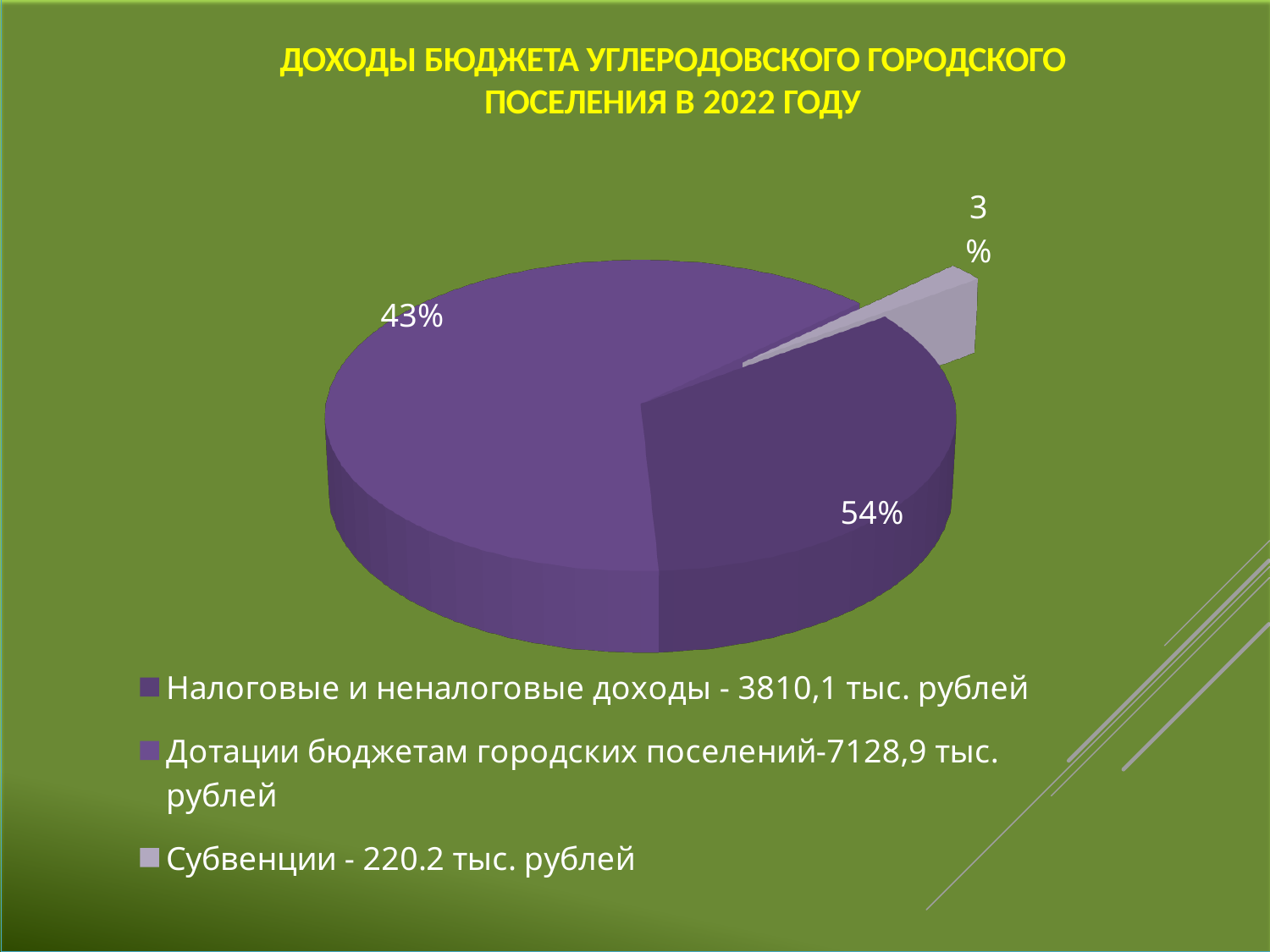
What amount does the legend give for Дотации бюджетам городских поселений? 7128,9 тыс. рублей What is the largest percentage label shown on the pie chart? 54% What is the title of the slide? ДОХОДЫ БЮДЖЕТА УГЛЕРОДОВСКОГО ГОРОДСКОГО ПОСЕЛЕНИЯ В 2022 ГОДУ What amount does the legend give for Субвенции? 220.2 тыс. рублей How many entries does the legend list? 3 What share of the pie is labelled for the Субвенции slice? 3% What amount does the legend give for Налоговые и неналоговые доходы? 3810,1 тыс. рублей What kind of chart is shown on the slide? pie chart Which category has the smallest share of the pie? Субвенции Which is larger according to the legend: Налоговые и неналоговые доходы or Дотации бюджетам городских поселений? Дотации бюджетам городских поселений What is the smallest percentage label shown on the pie chart? 3% How many slices does the pie chart have? 3